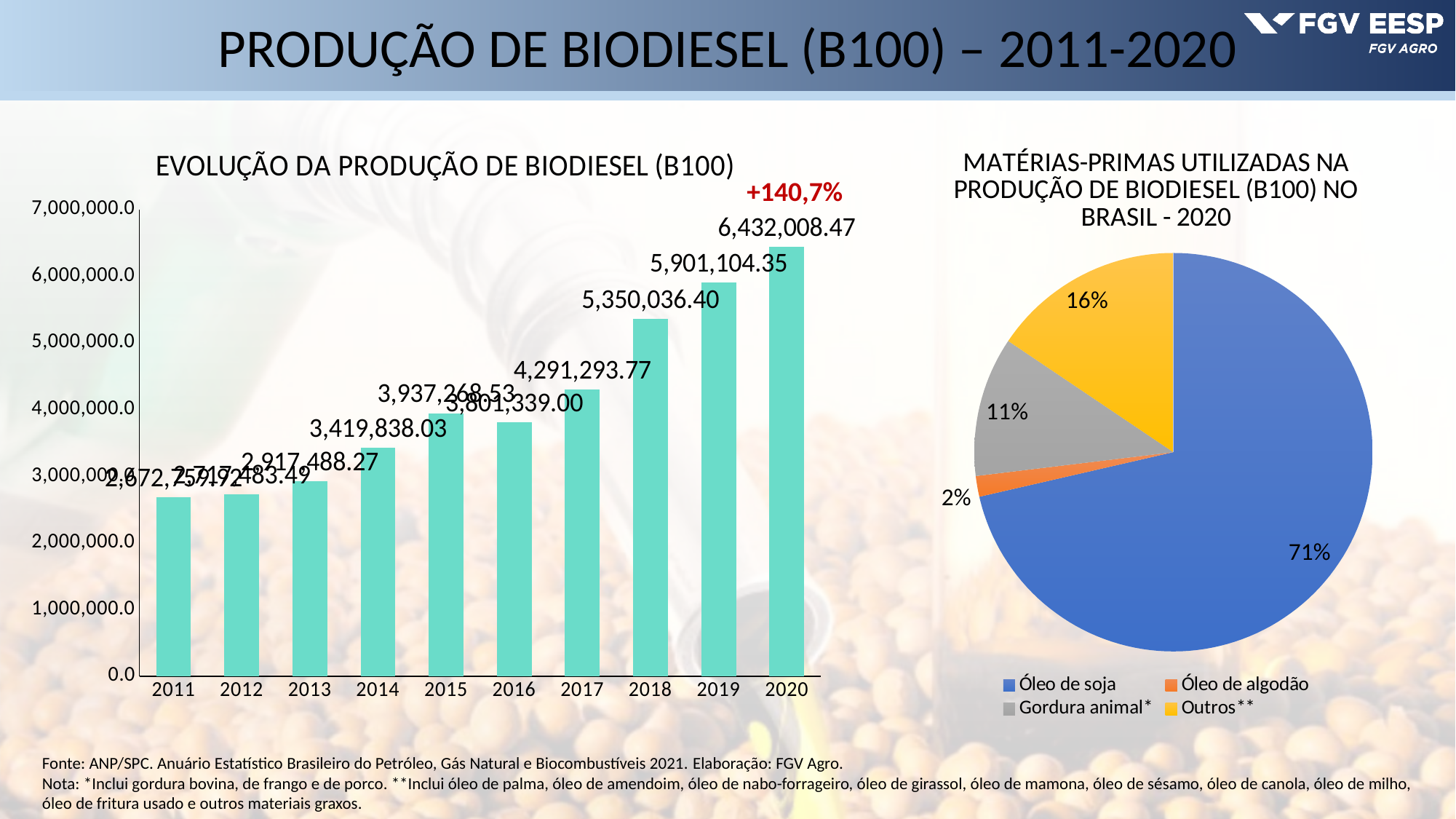
In the bar chart 'EVOLUÇÃO DA PRODUÇÃO DE BIODIESEL (B100)', what is the value for 2020? 6,432,008.47 How many years are shown in the bar chart 'EVOLUÇÃO DA PRODUÇÃO DE BIODIESEL (B100)'? 10 In the bar chart 'EVOLUÇÃO DA PRODUÇÃO DE BIODIESEL (B100)', is the value for 2016 greater or less than 4,000,000? less In the bar chart 'EVOLUÇÃO DA PRODUÇÃO DE BIODIESEL (B100)', which year has the highest value? 2020 In the pie chart 'MATÉRIAS-PRIMAS UTILIZADAS NA PRODUÇÃO DE BIODIESEL (B100) NO BRASIL - 2020', which category has the smallest share? Óleo de algodão What kind of chart is the left chart 'EVOLUÇÃO DA PRODUÇÃO DE BIODIESEL (B100)'? bar chart In the bar chart 'EVOLUÇÃO DA PRODUÇÃO DE BIODIESEL (B100)', what is the value for 2014? 3,419,838.03 In the pie chart 'MATÉRIAS-PRIMAS UTILIZADAS NA PRODUÇÃO DE BIODIESEL (B100) NO BRASIL - 2020', what share does Óleo de soja have? 71% How many categories does the legend of the pie chart 'MATÉRIAS-PRIMAS UTILIZADAS NA PRODUÇÃO DE BIODIESEL (B100) NO BRASIL - 2020' list? 4 In the bar chart 'EVOLUÇÃO DA PRODUÇÃO DE BIODIESEL (B100)', which is larger, the value for 2017 or 2018? 2018 In the bar chart 'EVOLUÇÃO DA PRODUÇÃO DE BIODIESEL (B100)', what is the difference between the values for 2020 and 2019? 530,904.12 In the bar chart 'EVOLUÇÃO DA PRODUÇÃO DE BIODIESEL (B100)', which year has the lowest value? 2011